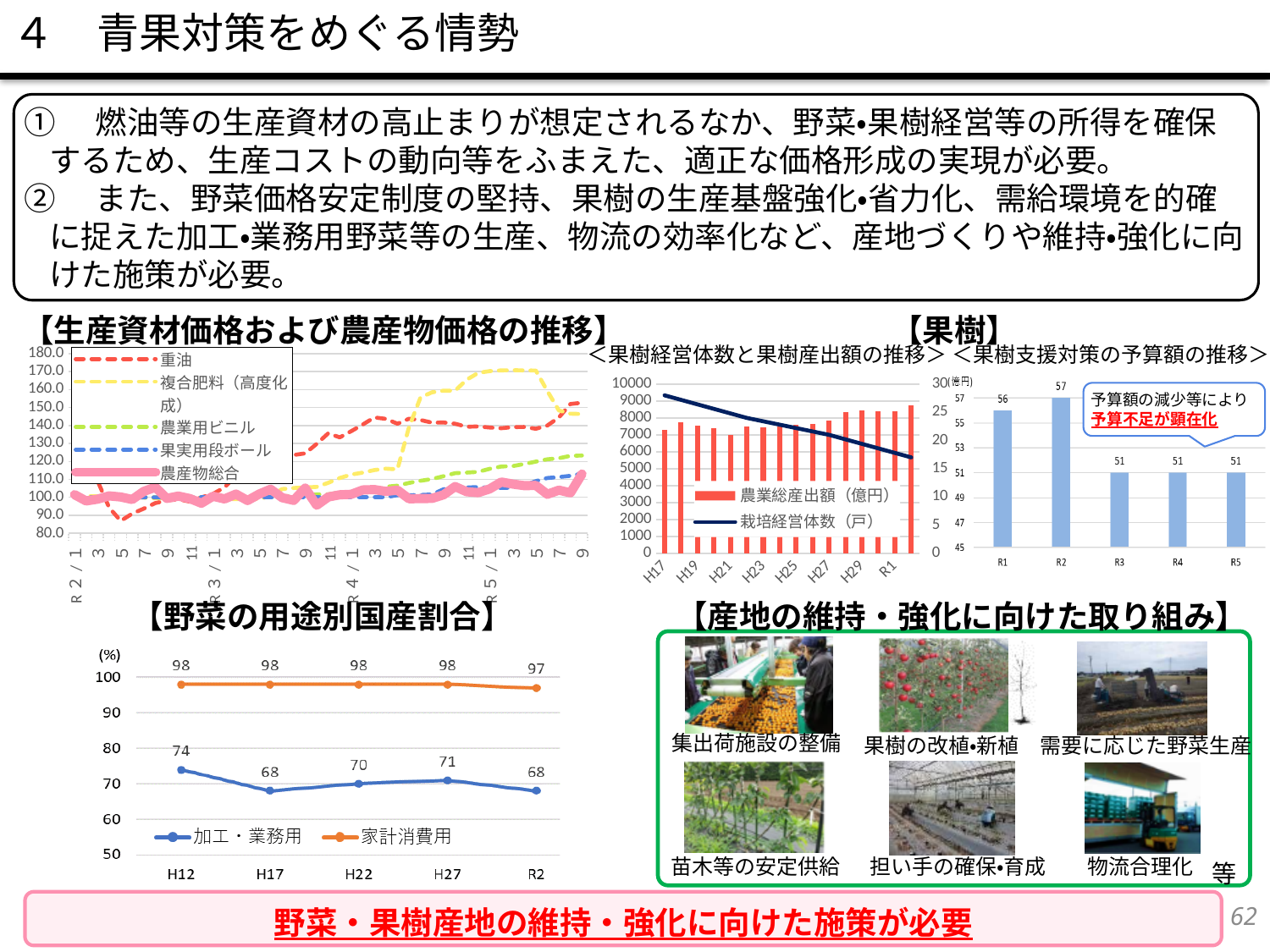
In the 果樹経営体数と果樹産出額の推移 chart, does the 栽培経営体数（戸） line rise or fall from H17 to R1? fall In the 野菜の用途別国産割合 chart, what is the value for 加工・業務用 at H12? 74 In the 果樹支援対策の予算額の推移 chart, how many bars are plotted? 5 In the 果樹支援対策の予算額の推移 chart, which year has the highest value? R2 In the 野菜の用途別国産割合 chart, what is the value for 家計消費用 at R2? 97 In the 野菜の用途別国産割合 chart, what is the difference between 家計消費用 and 加工・業務用 at H22? 28 In the 野菜の用途別国産割合 chart, how many series does the legend list? 2 In the 果樹支援対策の予算額の推移 chart, what is the value for R4? 51 In the 野菜の用途別国産割合 chart, which series has the larger value at H27, 加工・業務用 or 家計消費用? 家計消費用 How many series does the legend of the 生産資材価格および農産物価格の推移 chart list? 5 In the 果樹支援対策の予算額の推移 chart, what is the value for R2? 57 In the 果樹支援対策の予算額の推移 chart, what is the difference between the R2 value and the R3 value? 6